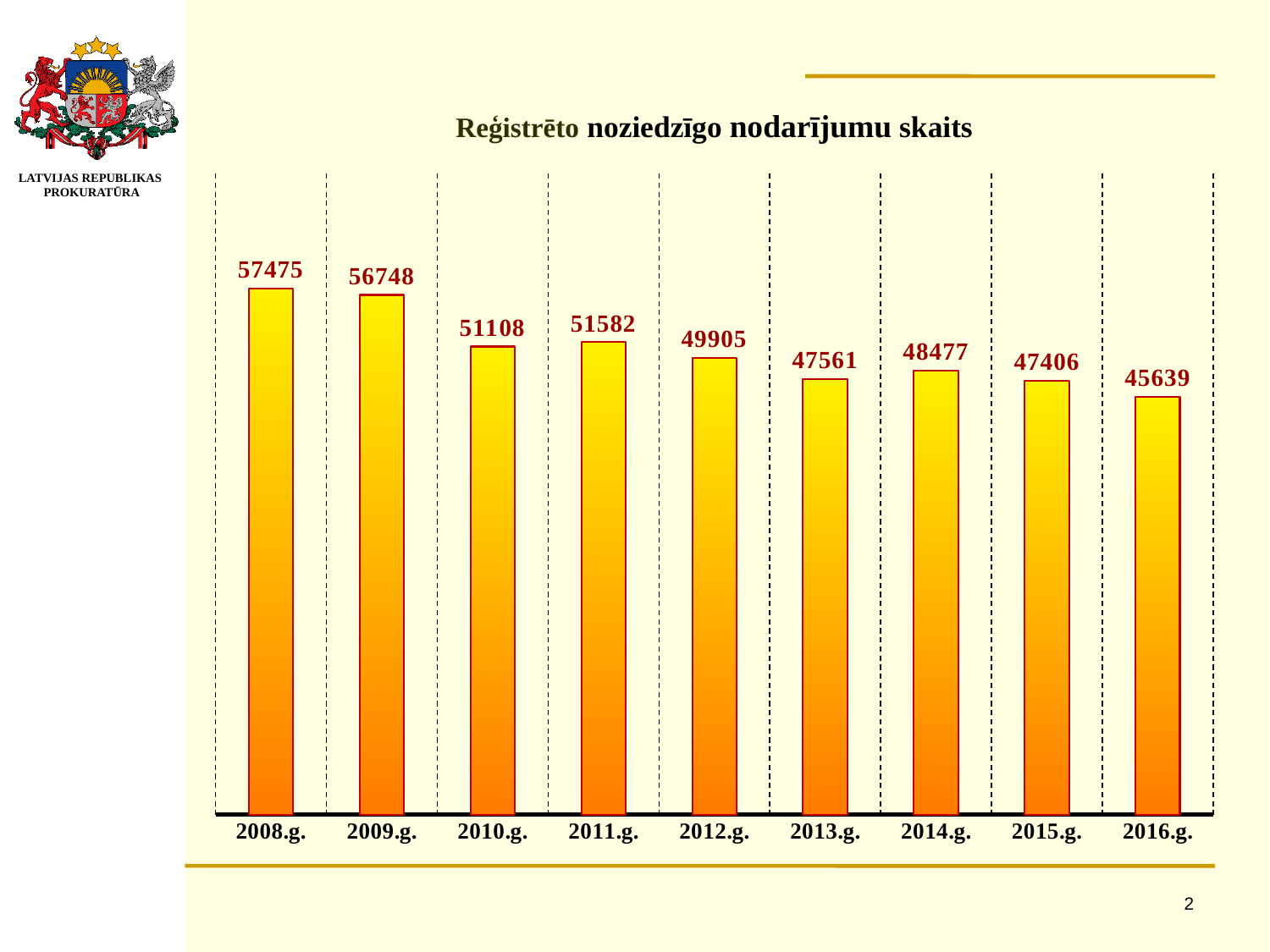
What is the difference between the values for 2008.g. and 2016.g.? 11836 Which is larger, the value for 2013.g. or the value for 2014.g.? 2014.g. What kind of chart is this? bar chart Which year has the lowest value? 2016.g. Which year has the highest value? 2008.g. What is the difference between the values for 2010.g. and 2011.g.? 474 What is the title of the chart? Reģistrēto noziedzīgo nodarījumu skaits What is the value for 2016.g.? 45639 How many years are shown on the x axis? 9 What is the value for 2012.g.? 49905 What is the value for 2008.g.? 57475 Which is larger, the value for 2009.g. or the value for 2010.g.? 2009.g.